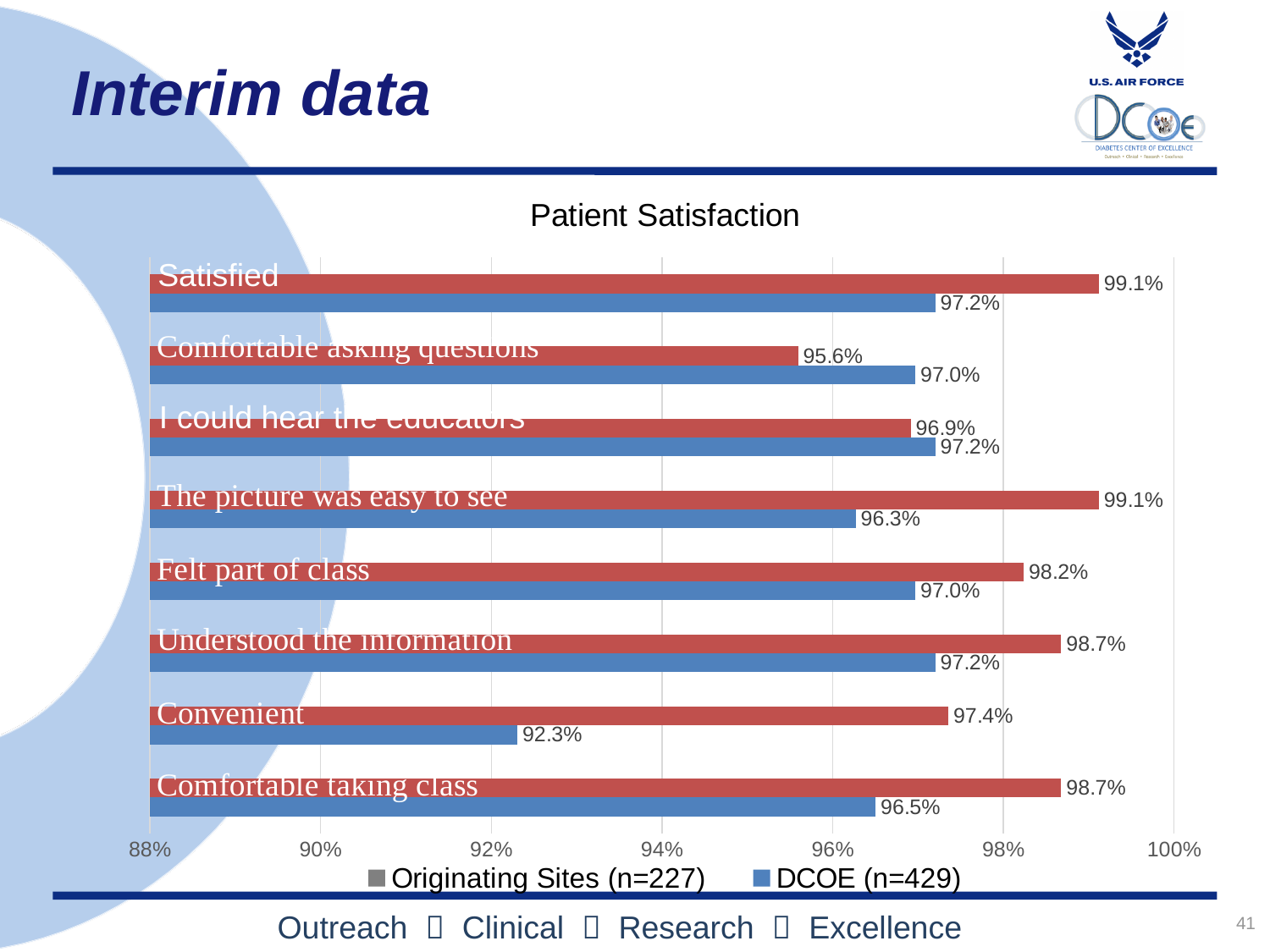
What kind of chart is shown on the slide? Bar chart How many categories are shown on the chart? 8 Which category has the lowest Originating Sites (n=227) value? Comfortable asking questions How many series does the legend list? 2 What is the Originating Sites (n=227) value for Convenient? 97.4% For Comfortable asking questions, which is larger: the Originating Sites (n=227) value or the DCOE (n=429) value? DCOE (n=429) What is the Originating Sites (n=227) value for Felt part of class? 98.2% What is the difference between the Originating Sites (n=227) and DCOE (n=429) values for Convenient? 5.1% What is the title of the chart? Patient Satisfaction What is the DCOE (n=429) value for Convenient? 92.3% Which category has the lowest DCOE (n=429) value? Convenient What is the DCOE (n=429) value for The picture was easy to see? 96.3%